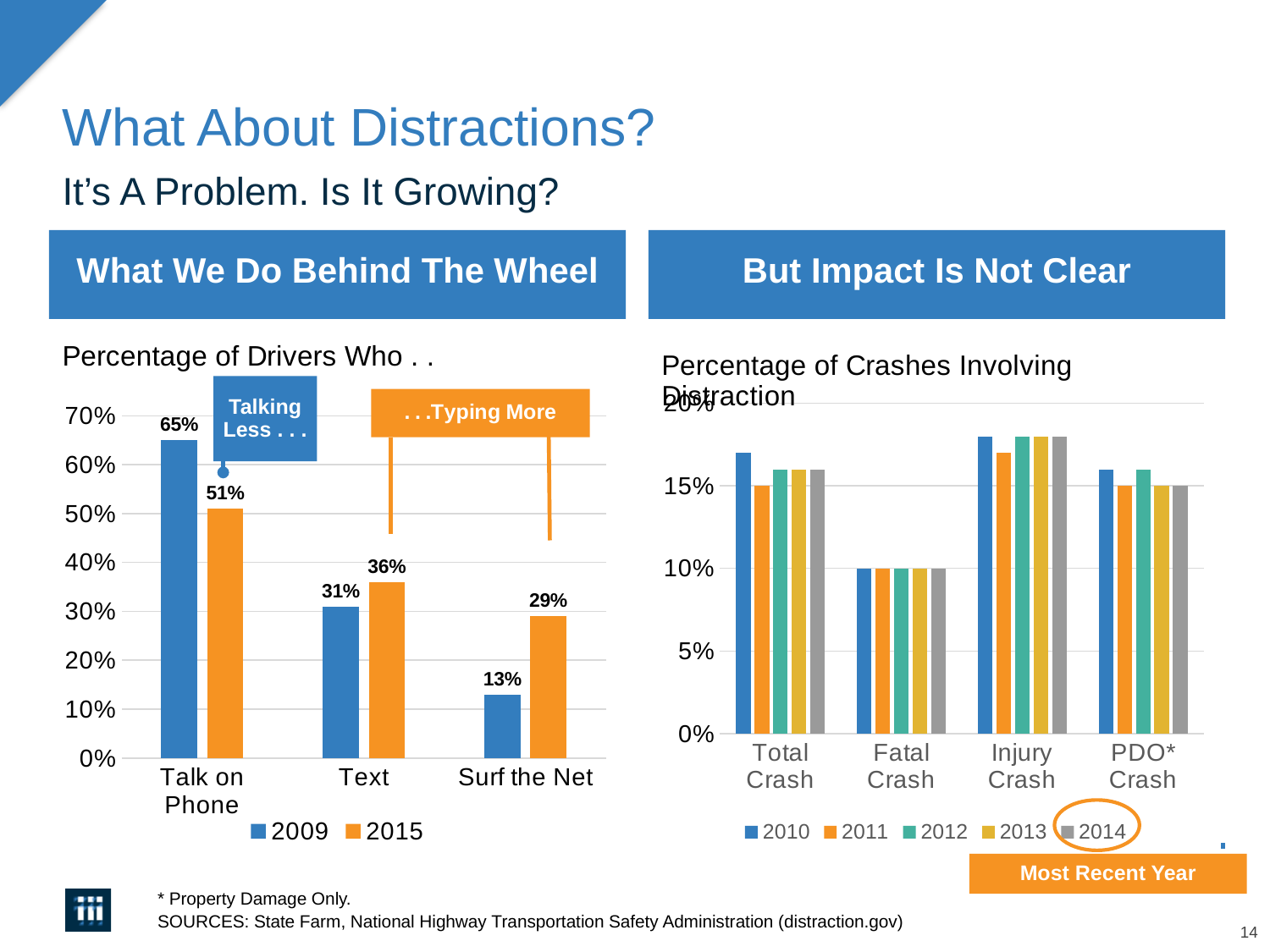
In the right chart, how many series does the legend list? 5 In the left chart, what percentage of drivers surfed the net in 2015? 29% In the right chart, what is the value for Fatal Crash in 2014? 10% In the right chart, which year is circled in the legend? 2014 In the left chart, how many categories are shown on the x axis? 3 In the left chart, which is larger for Text: the 2009 value or the 2015 value? 2015 What kind of chart is the right chart, titled 'Percentage of Crashes Involving Distraction'? bar chart In the left chart, what is the 2015 value for Text? 36% In the left chart, what is the difference between the 2009 and 2015 values for Talk on Phone? 14% In the left chart, which category has the lowest value for 2009? Surf the Net In the right chart, is the value for Injury Crash in 2010 greater or less than 15%? greater In the left chart, what percentage of drivers talked on the phone in 2009? 65%